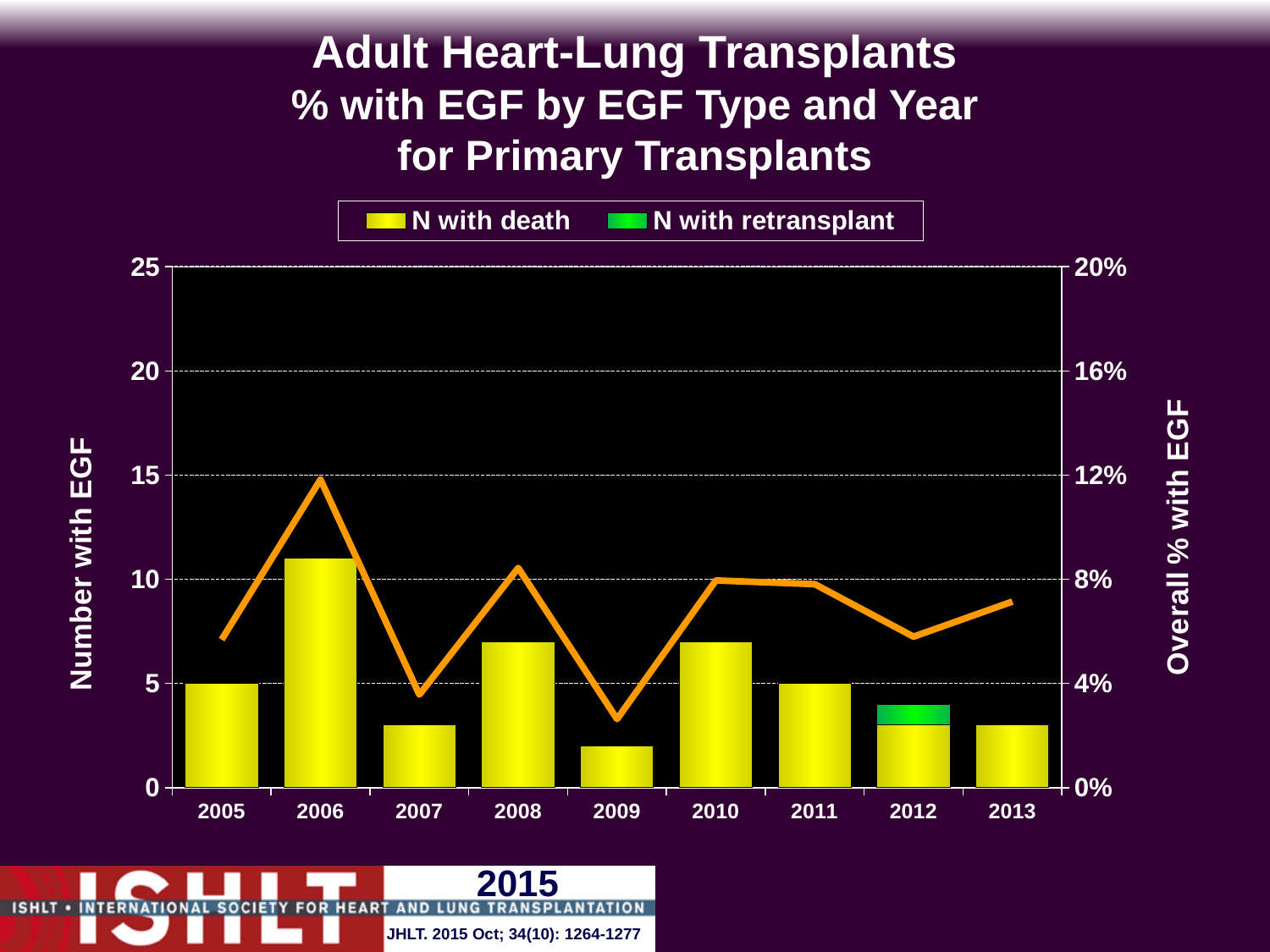
Which year has the shortest bar for Number with EGF? 2009 Is the N with death value for 2006 greater or less than 10? greater What is the value of N with death for 2011? 5 How many series does the legend list? 2 Which year has a larger N with death bar, 2008 or 2009? 2008 What is the value of N with death for 2005? 5 What kind of chart is shown on the slide? bar chart with a line Is the Overall % with EGF line value for 2006 greater or less than 8%? greater How many years are shown on the x axis? 9 Which year has the tallest bar for Number with EGF? 2006 Which year is the only one with an N with retransplant (green) segment? 2012 Is the N with death value for 2009 greater or less than 5? less